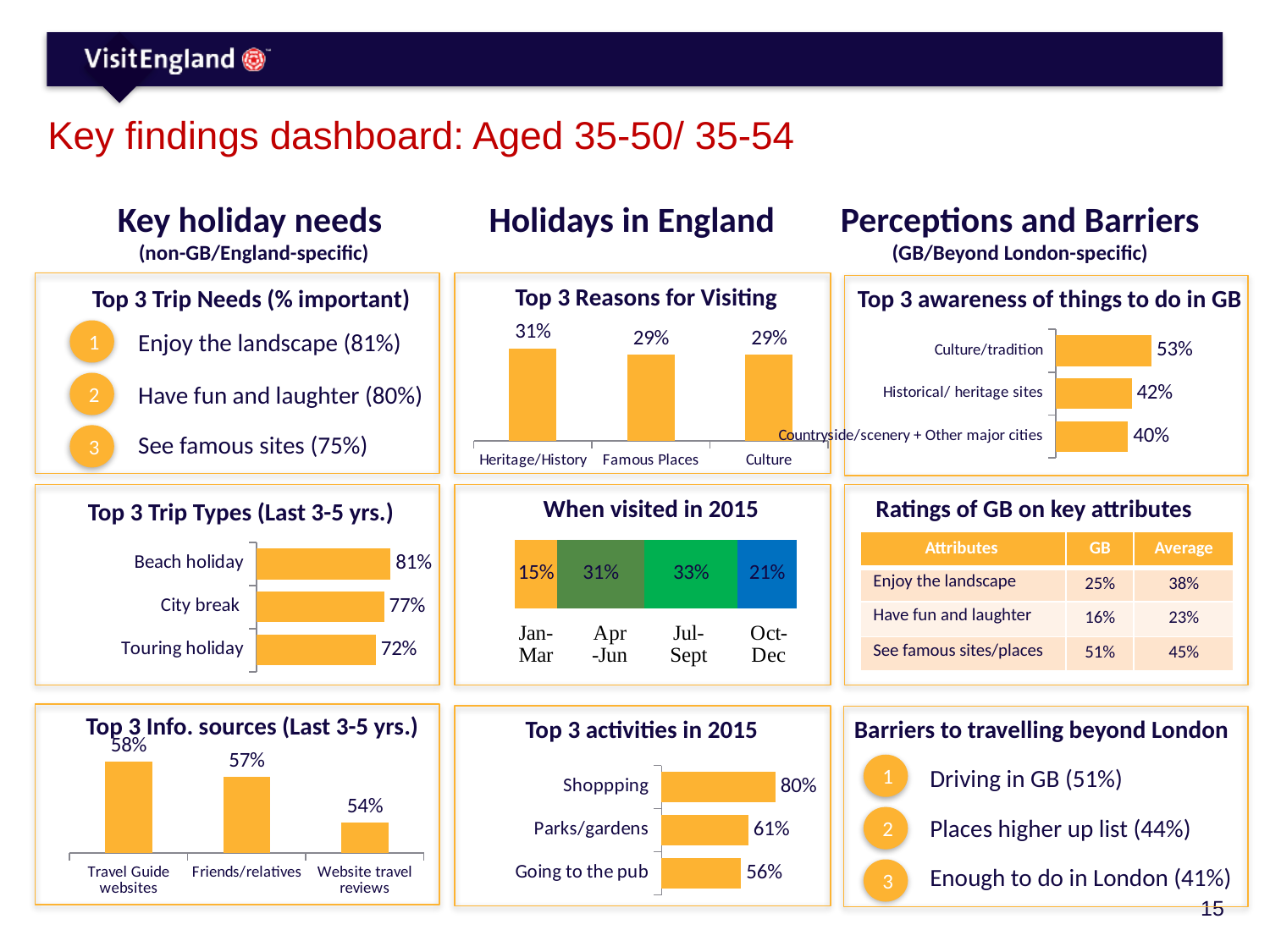
In the 'Top 3 activities in 2015' chart, what is the difference between Shoppping and Going to the pub? 24% In the 'Top 3 Info. sources (Last 3-5 yrs.)' chart, what is the value for Website travel reviews? 54% In the 'Top 3 Trip Types (Last 3-5 yrs.)' chart, what is the value for City break? 77% In the 'Top 3 Reasons for Visiting' chart, which category has the highest value? Heritage/History In the 'When visited in 2015' chart, which is larger: Jan-Mar or Oct-Dec? Oct-Dec In the 'Top 3 Trip Types (Last 3-5 yrs.)' chart, which category has the lowest value? Touring holiday In the 'Top 3 awareness of things to do in GB' chart, what is the difference between Culture/tradition and Countryside/scenery + Other major cities? 13% In the 'Top 3 awareness of things to do in GB' chart, what is the value for Historical/ heritage sites? 42% What kind of chart is the 'Top 3 activities in 2015' chart? Bar chart In the 'When visited in 2015' chart, what is the value for Jul-Sept? 33% In the 'Top 3 Info. sources (Last 3-5 yrs.)' chart, how many categories are shown? 3 In the 'Top 3 Reasons for Visiting' chart, what is the value for Heritage/History? 31%